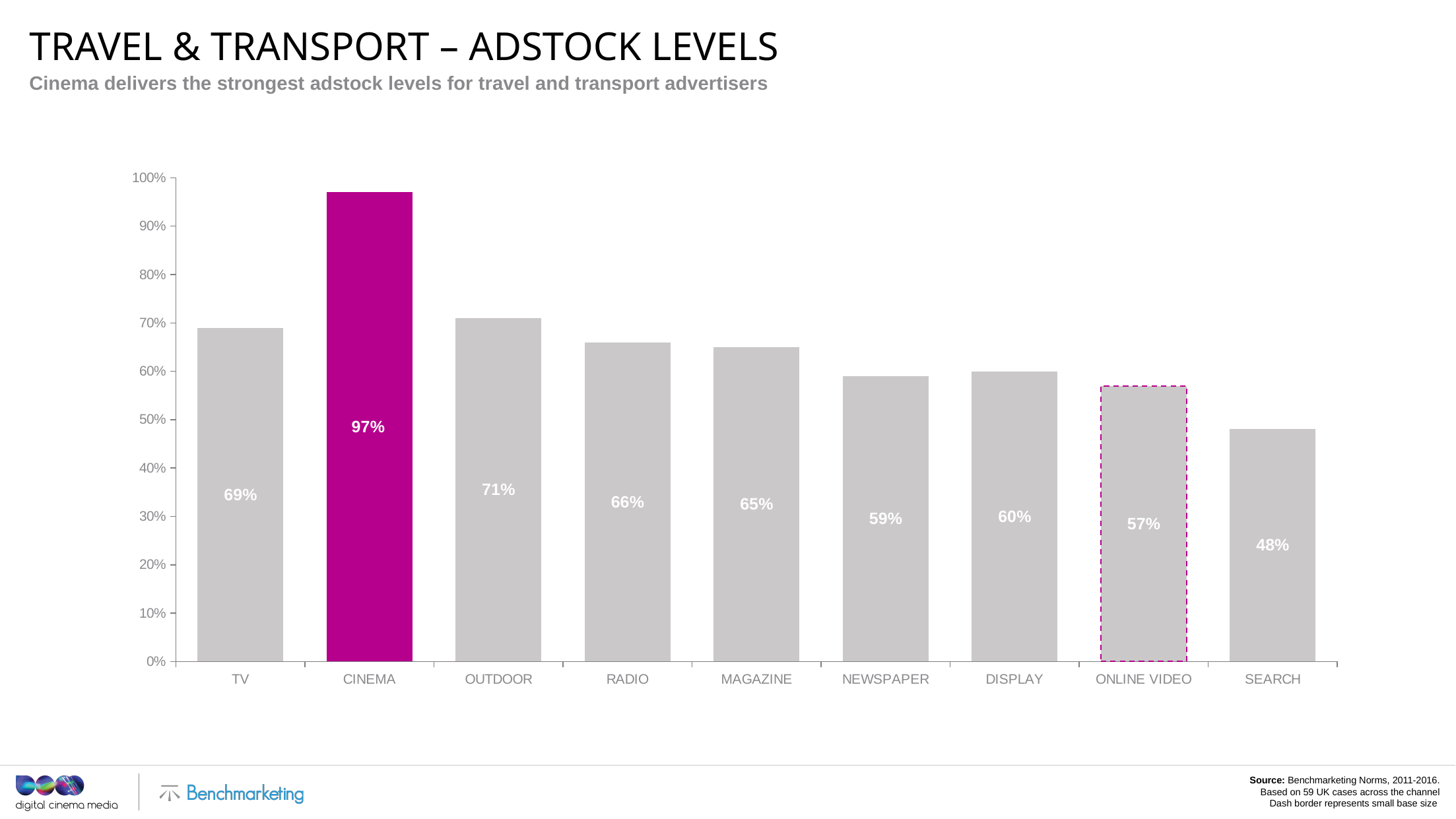
Is the value for Newspaper greater or less than 50%? greater What is the adstock level for Cinema? 97% Which bar is highlighted in a different colour from the others? Cinema What kind of chart is shown on the slide? Bar chart Which channel has the highest adstock level? Cinema What is the difference in adstock level between Outdoor and Search? 23% Which has a higher adstock level, Radio or Magazine? Radio How many channels are shown on the chart? 9 What is the adstock level for Online Video? 57% What is the difference in adstock level between Cinema and TV? 28% Which channel has the lowest adstock level? Search What is the adstock level for Search? 48%